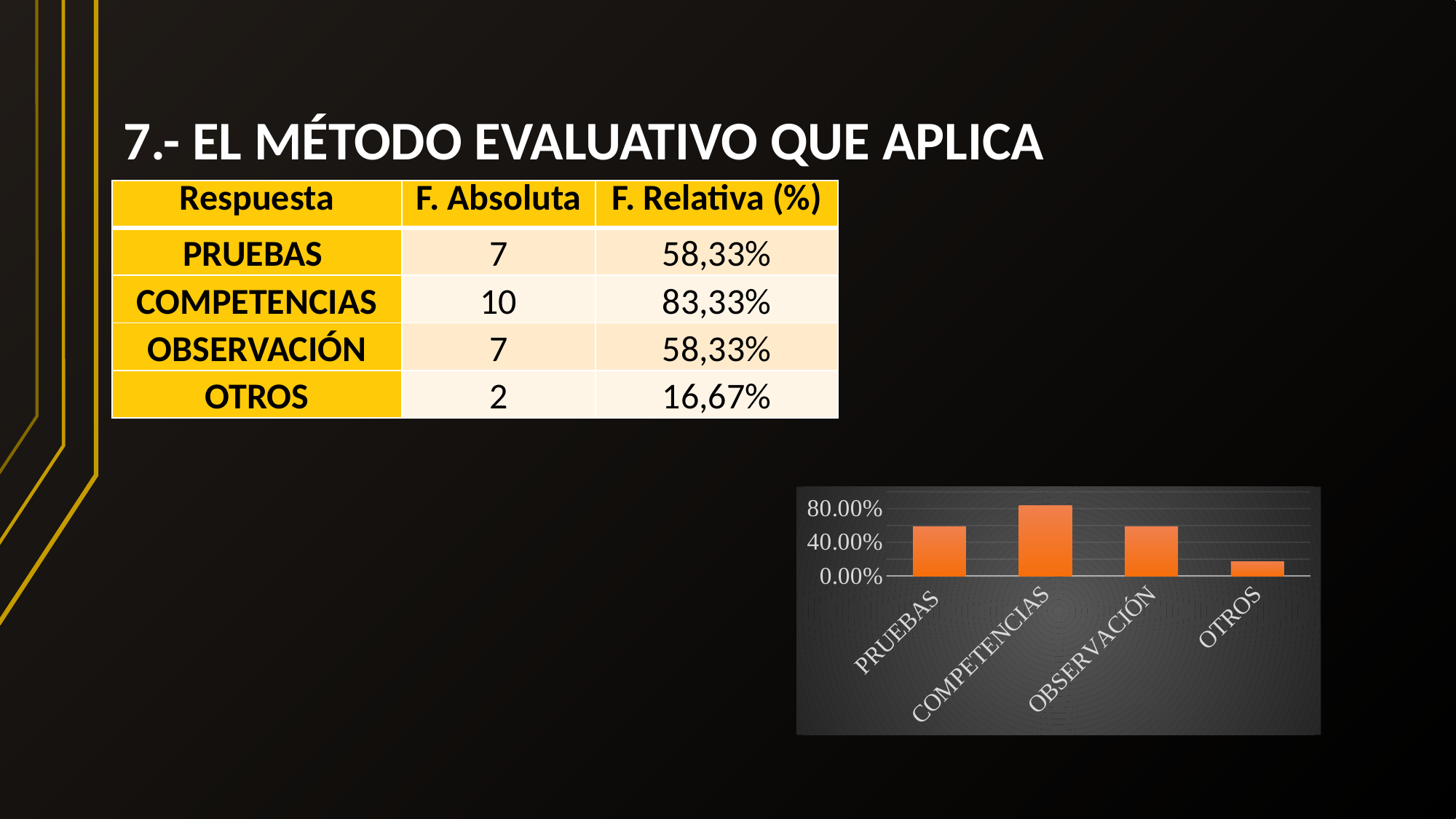
Is the value for OTROS greater or less than 40.00%? less Which is larger in the chart, the bar for COMPETENCIAS or the bar for PRUEBAS? COMPETENCIAS According to the slide, what relative frequency (F. Relativa) is plotted for OTROS? 16,67% Which is larger in the chart, the bar for OBSERVACIÓN or the bar for OTROS? OBSERVACIÓN What kind of chart is shown on the slide? bar chart What colour are the bars in the chart? orange How many categories does the bar chart show? 4 Which category has the tallest bar in the chart? COMPETENCIAS Is the value for PRUEBAS greater or less than 40.00%? greater Which category has the shortest bar in the chart? OTROS According to the slide, what relative frequency (F. Relativa) is plotted for COMPETENCIAS? 83,33% Is the value for OBSERVACIÓN greater or less than 40.00%? greater